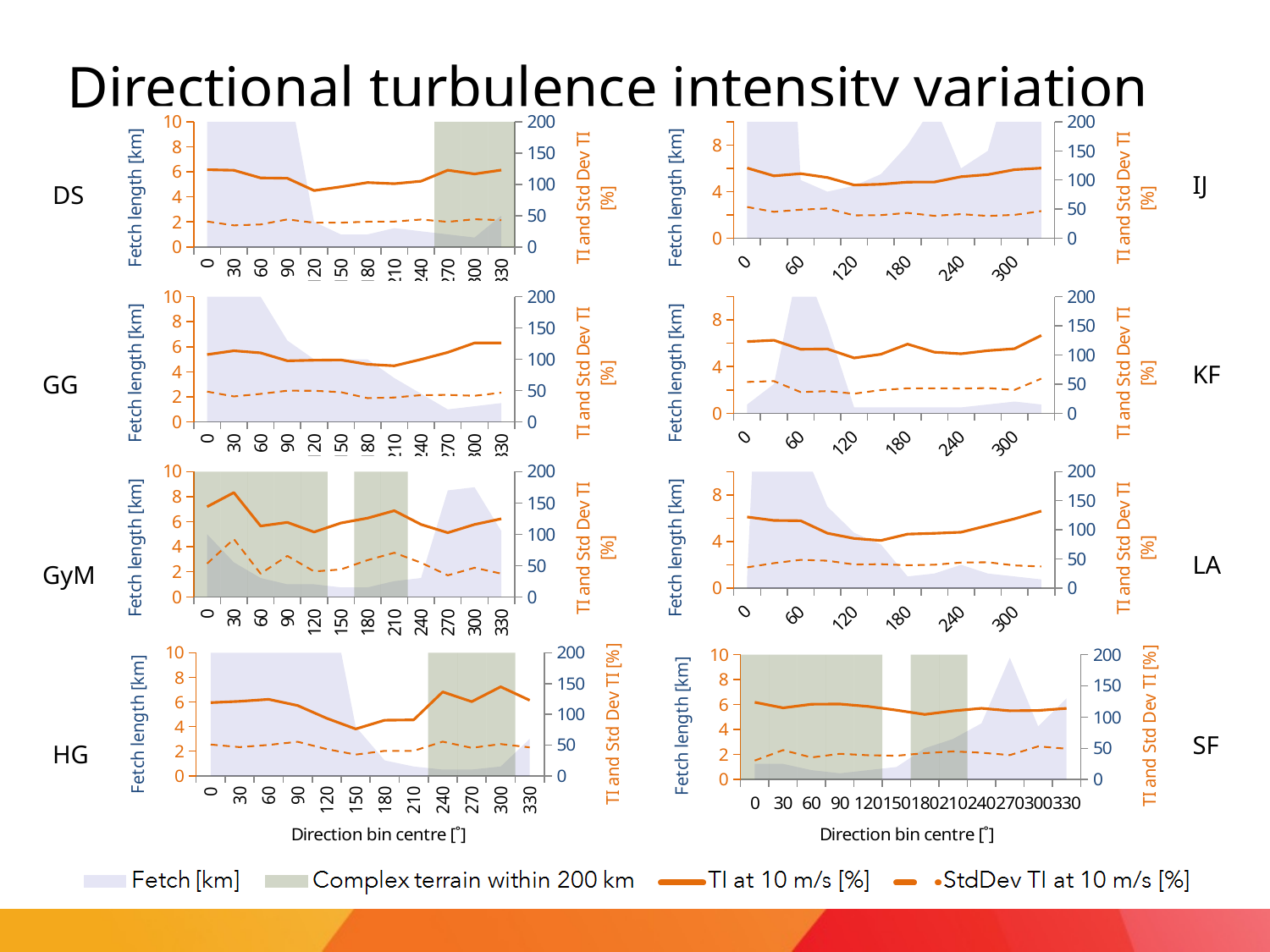
What is the x-axis label shown beneath the HG and SF charts? Direction bin centre [°] In the GyM chart, is the TI at 10 m/s value higher at the 30° bin or the 60° bin? 30° In the KF chart, is the TI at 10 m/s value at the 330° direction bin greater or less than 100? greater What kind of chart is used for each of the eight panels on the slide? combination area and line chart (lines with shaded areas) In the GyM chart, is the TI at 10 m/s value at the 30° direction bin greater or less than 150? greater In the GyM chart, which direction bin has the highest TI at 10 m/s value? 30° In the LA chart, does the TI at 10 m/s line rise or fall from the 0° bin to the 150° bin? fall How many direction bins are shown along the x axis of the HG chart? 12 In the HG chart, which direction bin has the lowest TI at 10 m/s value? 150° How many entries does the legend at the bottom of the slide list? 4 In the HG chart, is the TI at 10 m/s value at the 150° direction bin greater or less than 100? less